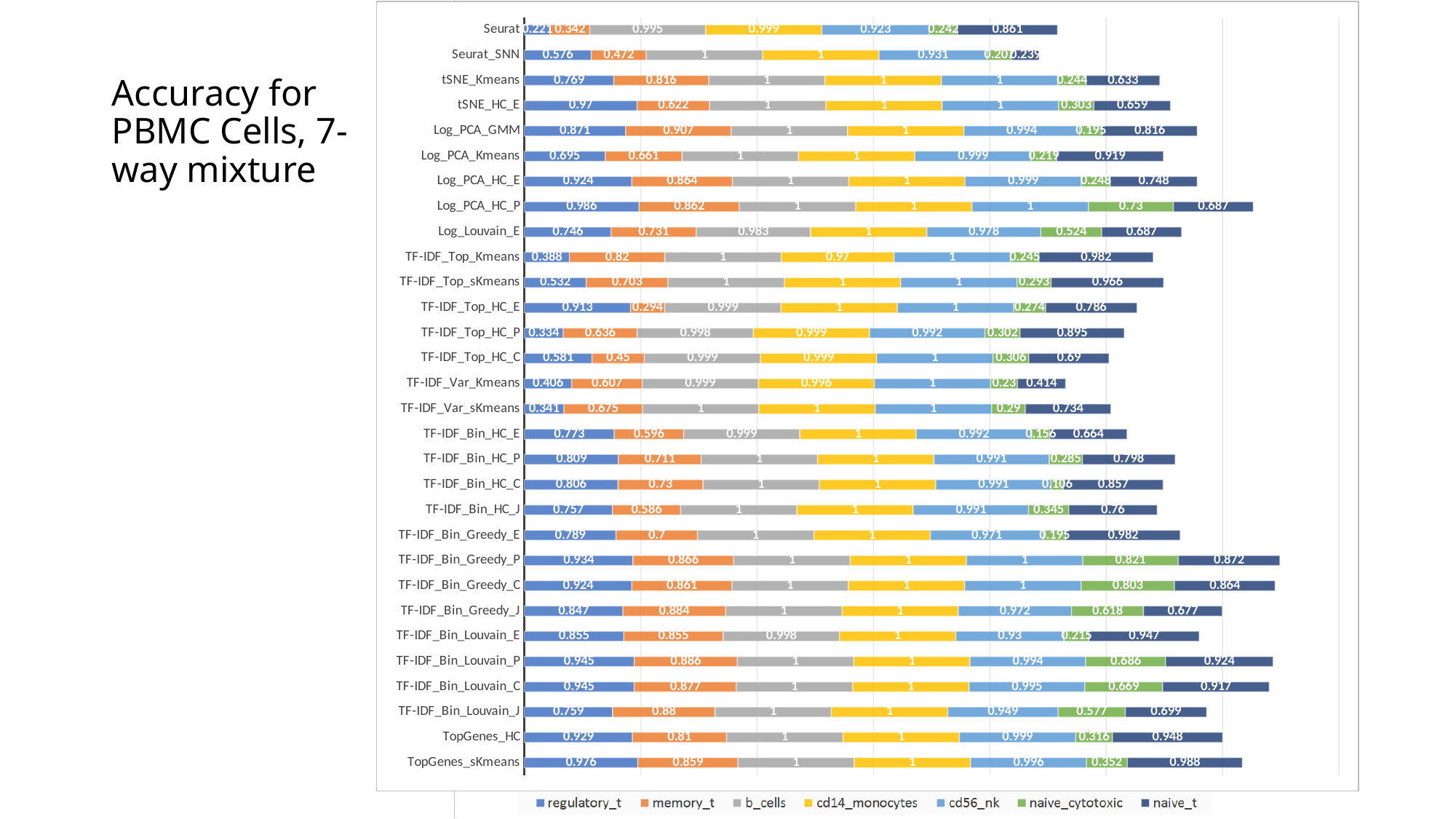
How many methods (categories) are plotted on the chart? 30 What is the regulatory_t value for TF-IDF_Bin_Louvain_P? 0.945 What is the difference between the naive_cytotoxic values of TF-IDF_Bin_Greedy_P and TF-IDF_Bin_Greedy_C? 0.018 How many series does the legend list? 7 Which has the larger regulatory_t value, tSNE_HC_E or tSNE_Kmeans? tSNE_HC_E Which method has the highest naive_cytotoxic value? TF-IDF_Bin_Greedy_P What is the memory_t value for Log_PCA_GMM? 0.907 What is the naive_t value for TopGenes_sKmeans? 0.988 What is the naive_cytotoxic value for TF-IDF_Bin_Greedy_P? 0.821 What kind of chart is shown on the slide? Stacked bar chart Which method has the lowest regulatory_t value? Seurat What is the total of the stacked bar for Seurat? 4.583